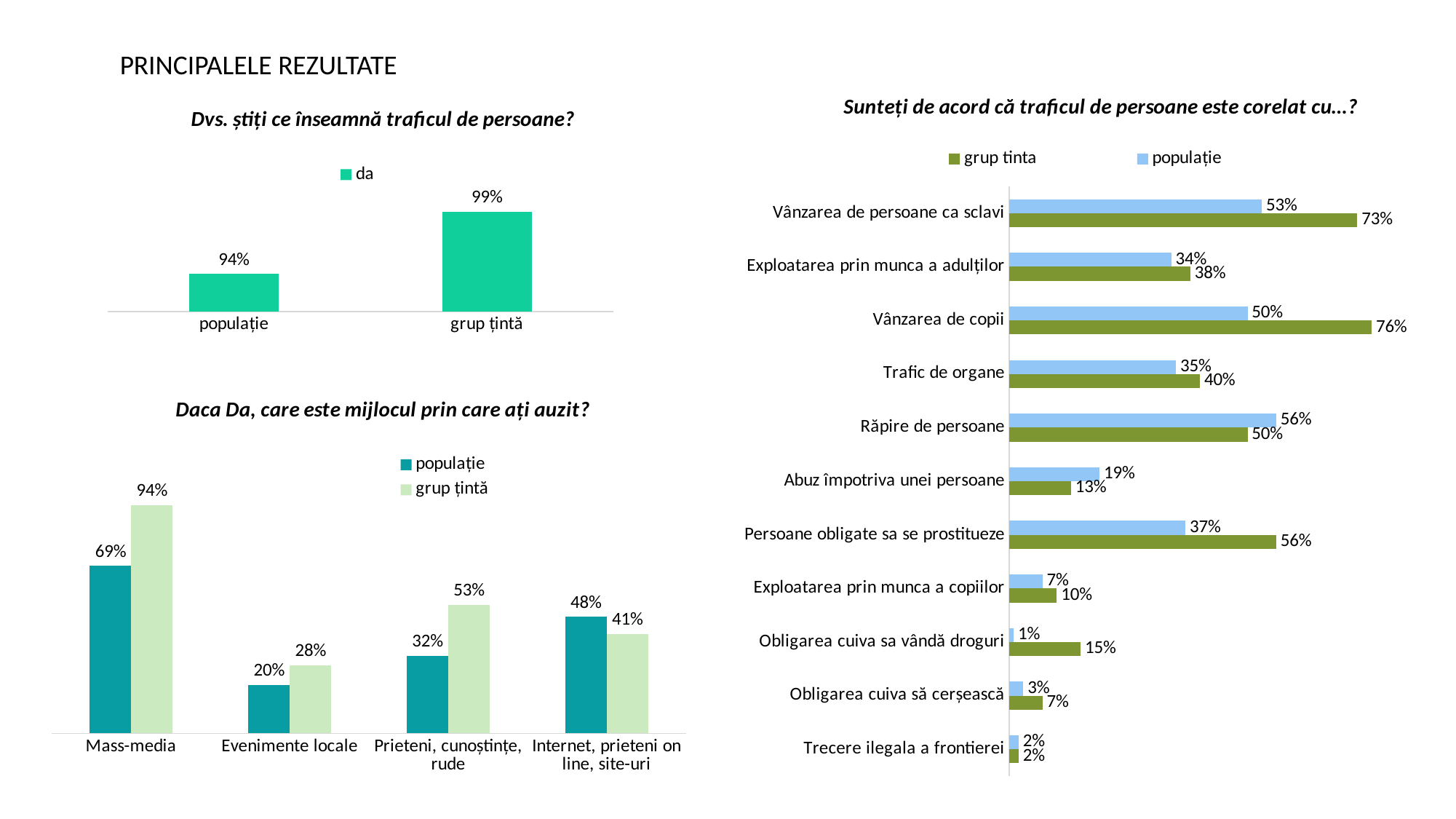
In the chart 'Sunteți de acord că traficul de persoane este corelat cu...?', how many categories are listed? 11 In the chart 'Daca Da, care este mijlocul prin care ați auzit?', which category has the lowest grup țintă value? Evenimente locale What type of chart is 'Sunteți de acord că traficul de persoane este corelat cu...?' bar chart In the chart 'Sunteți de acord că traficul de persoane este corelat cu...?', which category has the highest populație value? Răpire de persoane In the chart 'Sunteți de acord că traficul de persoane este corelat cu...?', what is the grup tinta value for 'Vânzarea de copii'? 76% In the chart 'Daca Da, care este mijlocul prin care ați auzit?', how many categories are shown on the x axis? 4 In the chart 'Dvs. știți ce înseamnă traficul de persoane?', what is the difference between grup țintă and populație? 5% In the chart 'Daca Da, care este mijlocul prin care ați auzit?', which is larger for 'Internet, prieteni on line, site-uri': populație or grup țintă? populație In the chart 'Sunteți de acord că traficul de persoane este corelat cu...?', what is the populație value for 'Persoane obligate sa se prostitueze'? 37% In the chart 'Sunteți de acord că traficul de persoane este corelat cu...?', what is the difference between grup tinta and populație for 'Vânzarea de persoane ca sclavi'? 20% In the chart 'Dvs. știți ce înseamnă traficul de persoane?', what is the value for grup țintă? 99% In the chart 'Daca Da, care este mijlocul prin care ați auzit?', what is the populație value for Mass-media? 69%